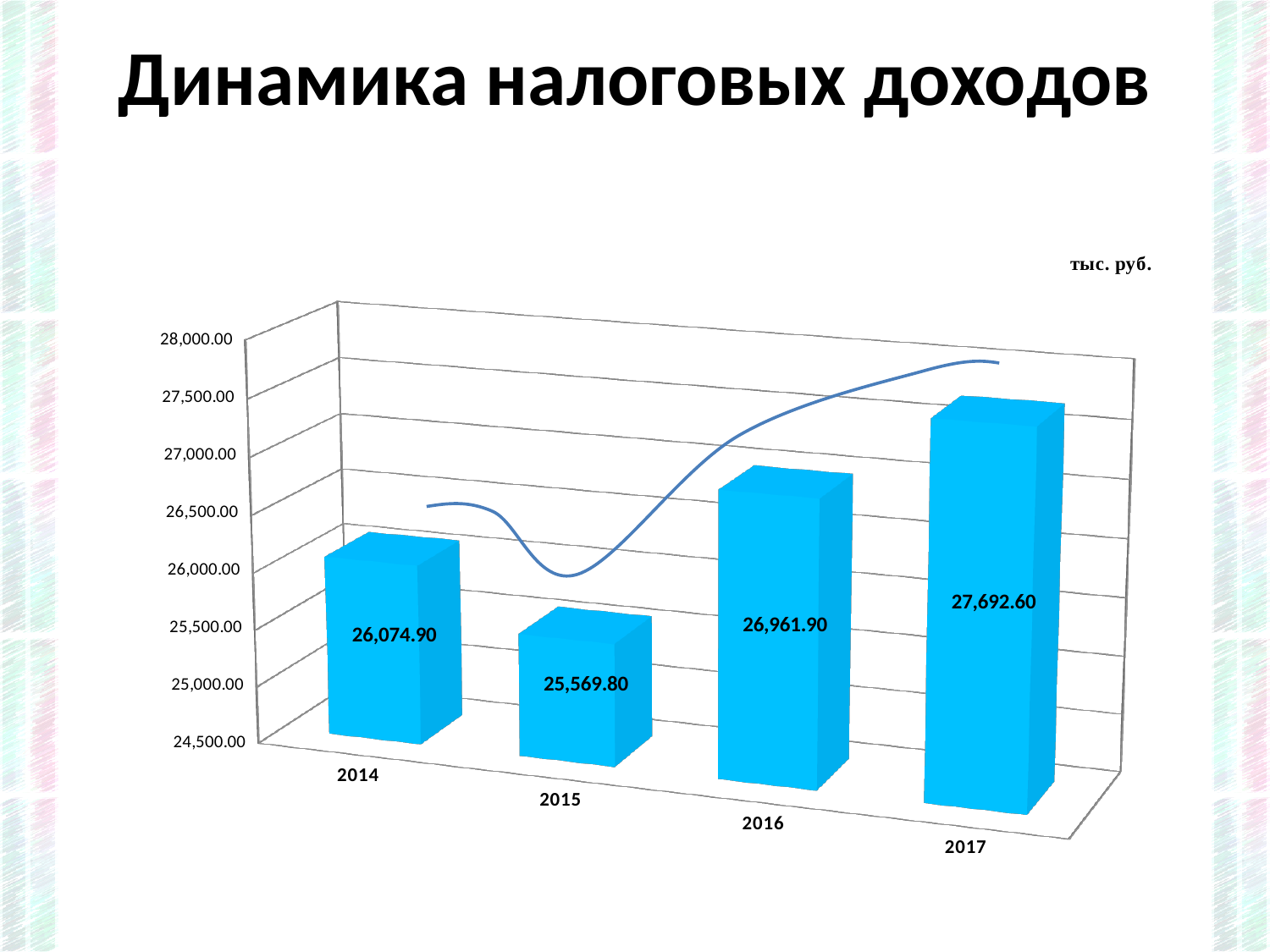
What is the value for 2015? 25,569.80 Which year has the lowest value? 2015 Which is larger, the value for 2014 or the value for 2016? 2016 What is the difference between the values for 2017 and 2016? 730.70 Which year has the highest value? 2017 What is the difference between the values for 2014 and 2015? 505.10 Do the values rise or fall from 2015 to 2017? Rise How many years are shown on the x axis? 4 What is the value for 2017? 27,692.60 What is the value for 2016? 26,961.90 What is the value for 2014? 26,074.90 What kind of chart is shown on the slide? Bar chart